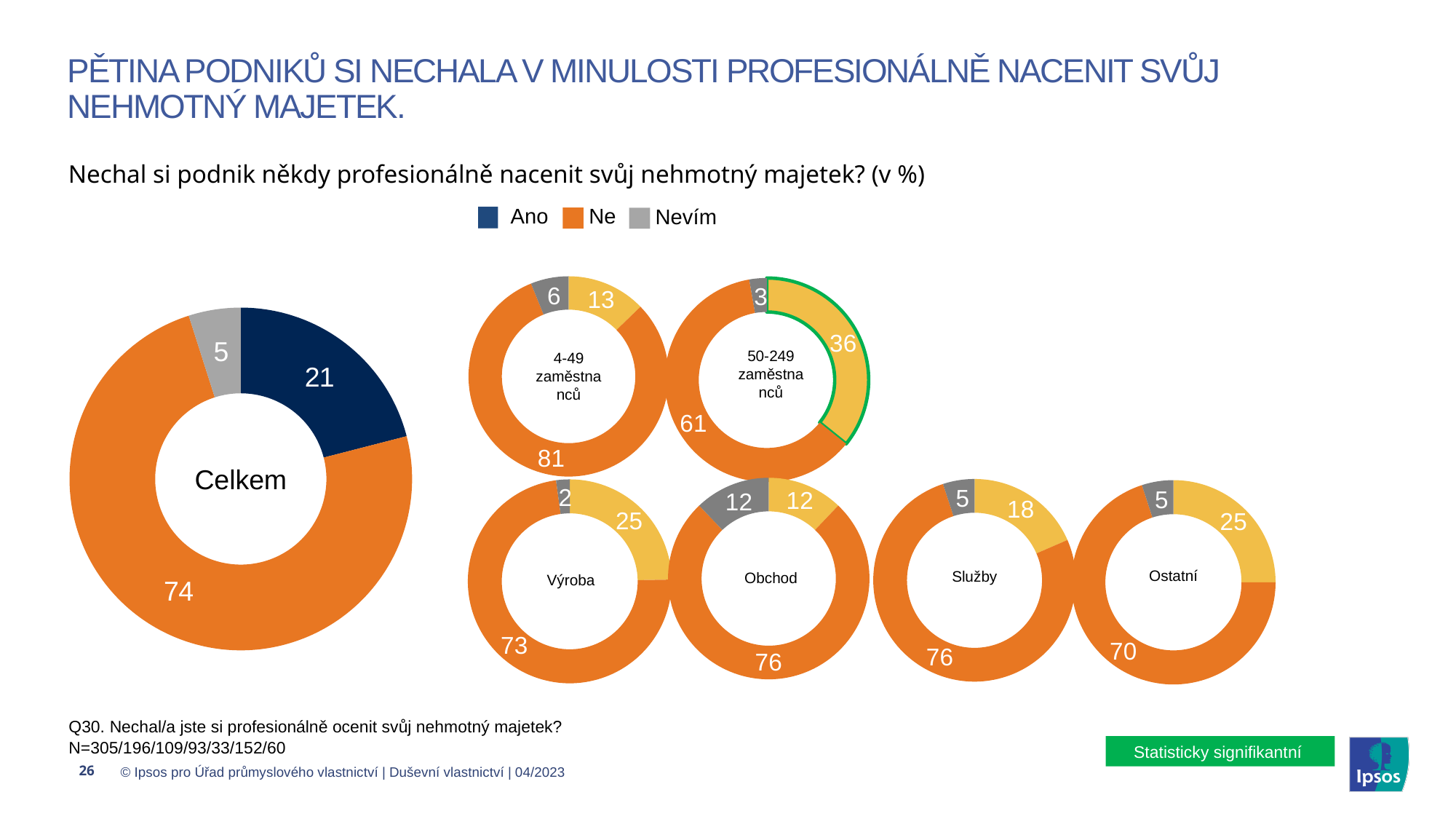
In the Celkem donut chart, which category has the largest share? Ne What kind of chart is the Celkem chart? Donut chart In the 50-249 zaměstnanců donut chart, what is the value of the Ne segment? 61 Which is larger: the Ne value in the Výroba donut chart or the Ne value in the Ostatní donut chart? Výroba In the Celkem donut chart, which category has the smallest share? Nevím How many series does the legend list? 3 In the Celkem donut chart, what is the value for Ano? 21 In the Obchod donut chart, what is the value of the Ne segment? 76 In the Celkem donut chart, what is the difference between the Ne value and the Ano value? 53 In the Celkem donut chart, what is the value for Ne? 74 In the Celkem donut chart, what is the value for Nevím? 5 In the 4-49 zaměstnanců donut chart, what is the value of the Nevím segment? 6